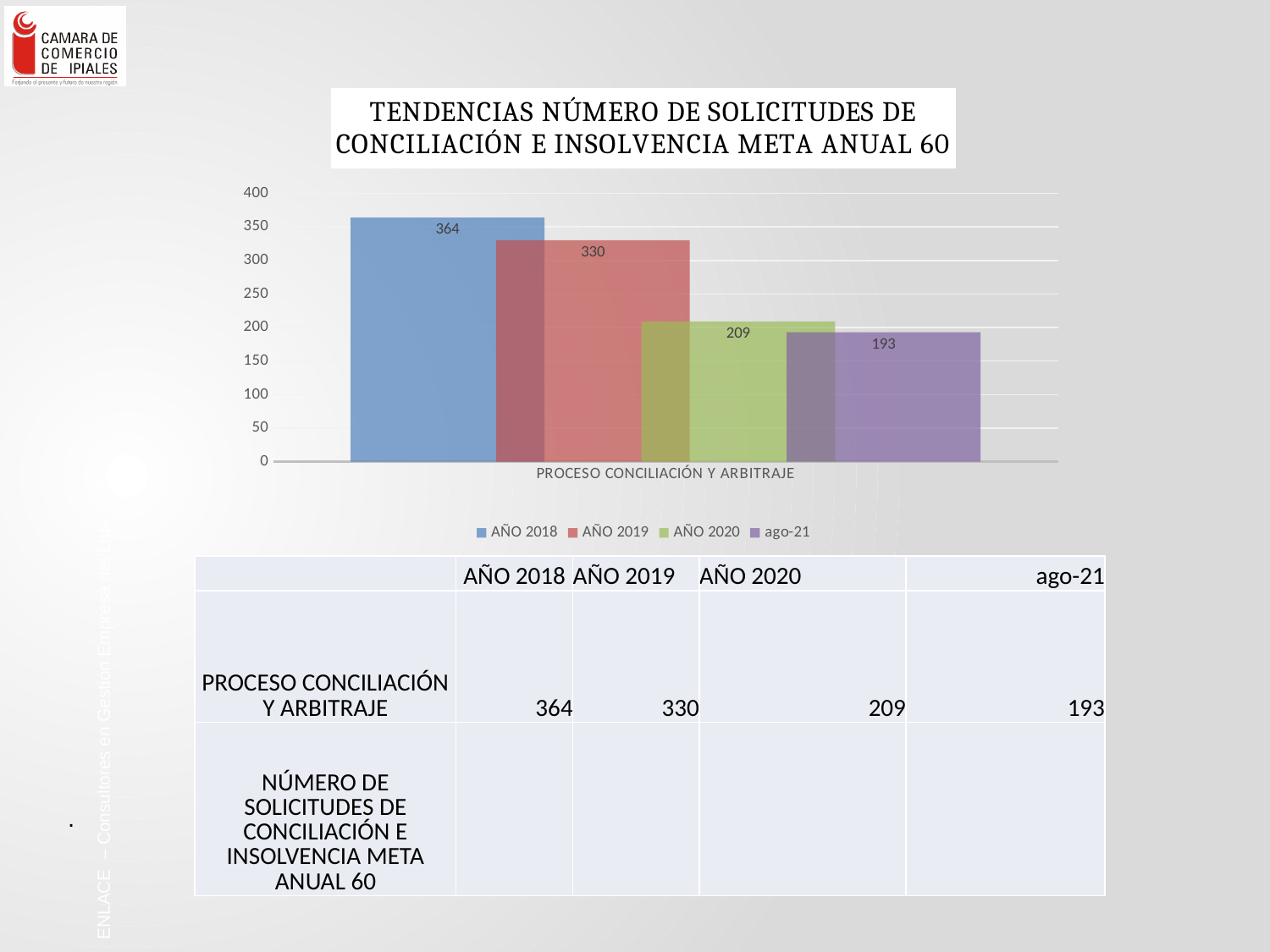
Which is larger, the value for AÑO 2019 or the value for AÑO 2020? AÑO 2019 What is the value for ago-21 in the chart? 193 What is the value for AÑO 2018 in the chart? 364 What is the value for AÑO 2020 in the chart? 209 Which series has the lowest value in the chart? ago-21 Which series has the highest value in the chart? AÑO 2018 How many series does the legend list? 4 What is the difference between the values for AÑO 2018 and AÑO 2019? 34 Do the values rise or fall from AÑO 2018 to ago-21? Fall What is the difference between the values for AÑO 2020 and ago-21? 16 What is the value for AÑO 2019 in the chart? 330 What kind of chart is shown on the slide? Bar chart